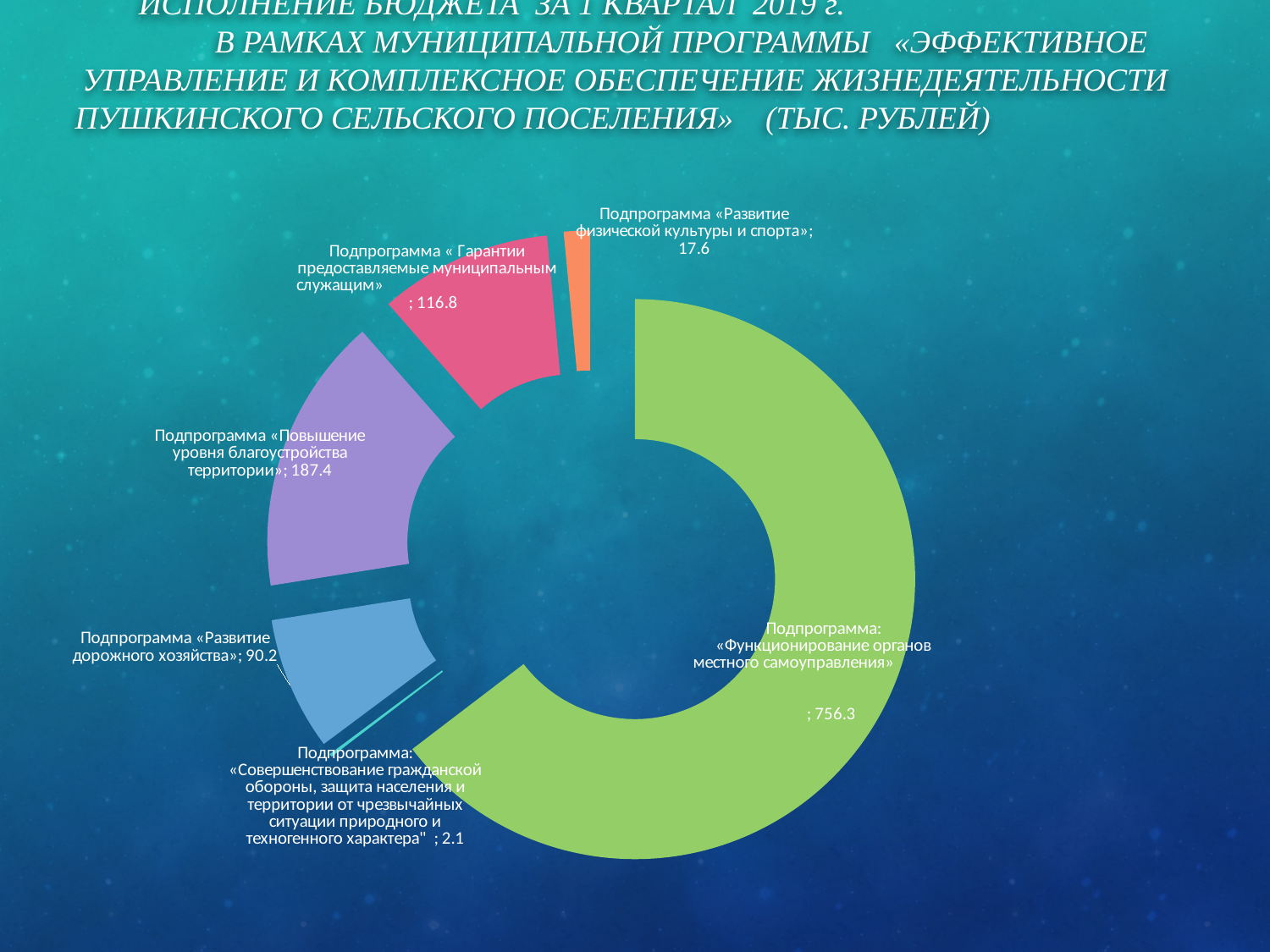
Which subprogram has the smallest value? «Совершенствование гражданской обороны, защита населения и территории от чрезвычайных ситуации природного и техногенного характера» What is the value for the subprogram «Повышение уровня благоустройства территории»? 187.4 What is the value for the subprogram «Развитие физической культуры и спорта»? 17.6 How many subprogram slices does the chart show? 6 What is the value for the subprogram «Гарантии предоставляемые муниципальным служащим»? 116.8 What colour is the slice for «Развитие физической культуры и спорта»? Orange Which is larger: the value for «Гарантии предоставляемые муниципальным служащим» or for «Развитие дорожного хозяйства»? «Гарантии предоставляемые муниципальным служащим» What is the difference between the values for «Функционирование органов местного самоуправления» and «Повышение уровня благоустройства территории»? 568.9 What kind of chart is shown on the slide? Doughnut chart Which subprogram has the largest value? «Функционирование органов местного самоуправления» What is the value for the subprogram «Развитие дорожного хозяйства»? 90.2 What is the value for the subprogram «Функционирование органов местного самоуправления»? 756.3